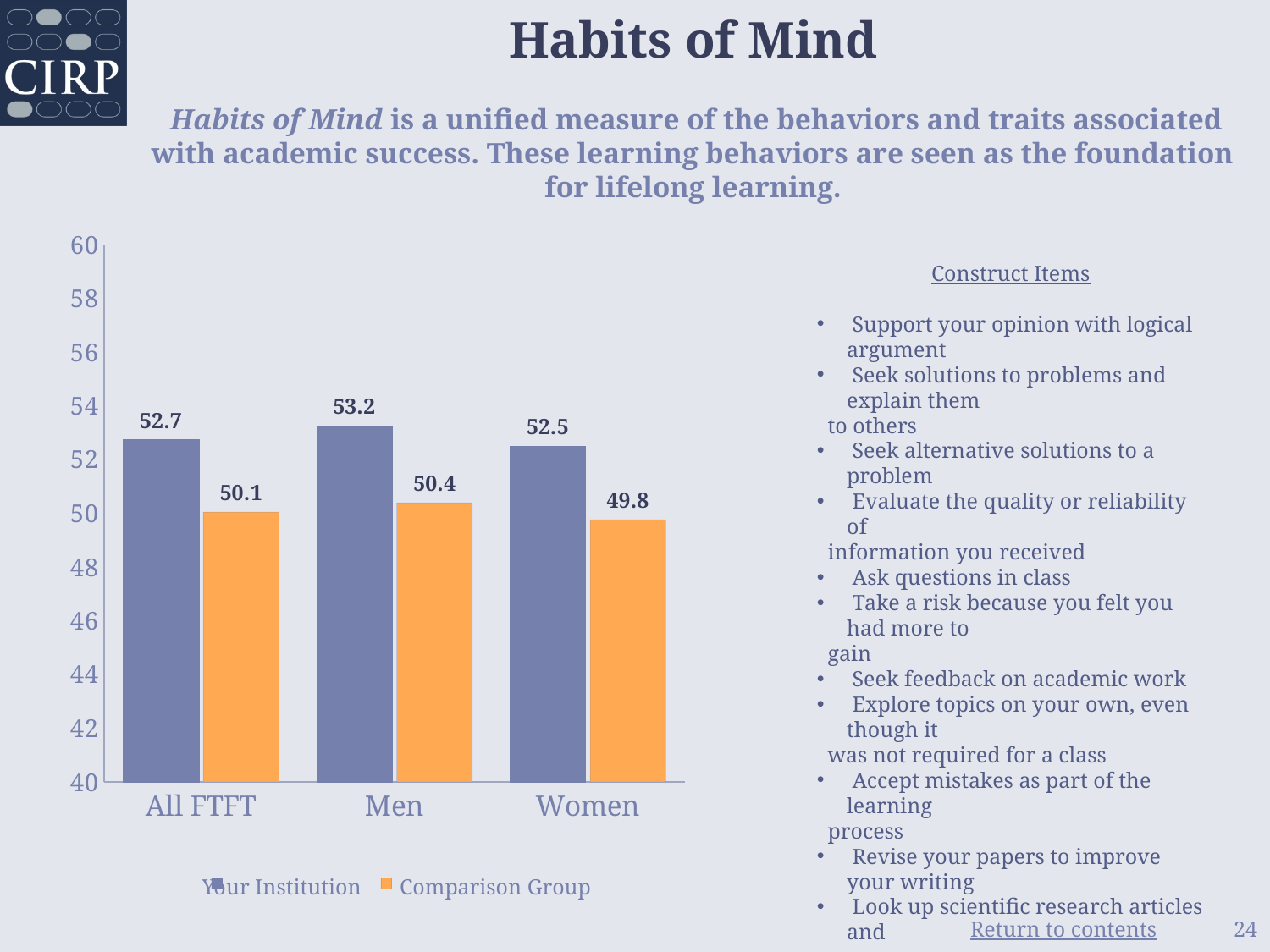
What is the value for the Comparison Group in the Women category? 49.8 How many categories are shown on the x axis? 3 Which is larger in the Women category, Your Institution or the Comparison Group? Your Institution How many series does the legend list? 2 What is the value for Your Institution in the All FTFT category? 52.7 What kind of chart is shown on the slide? bar chart Which category has the lowest value for the Comparison Group? Women What is the difference between Your Institution and the Comparison Group in the All FTFT category? 2.6 Which category has the highest value for Your Institution? Men What is the value for Your Institution in the Men category? 53.2 What is the difference between Your Institution and the Comparison Group in the Men category? 2.8 Is the value for the Comparison Group in the Women category greater or less than 50? less